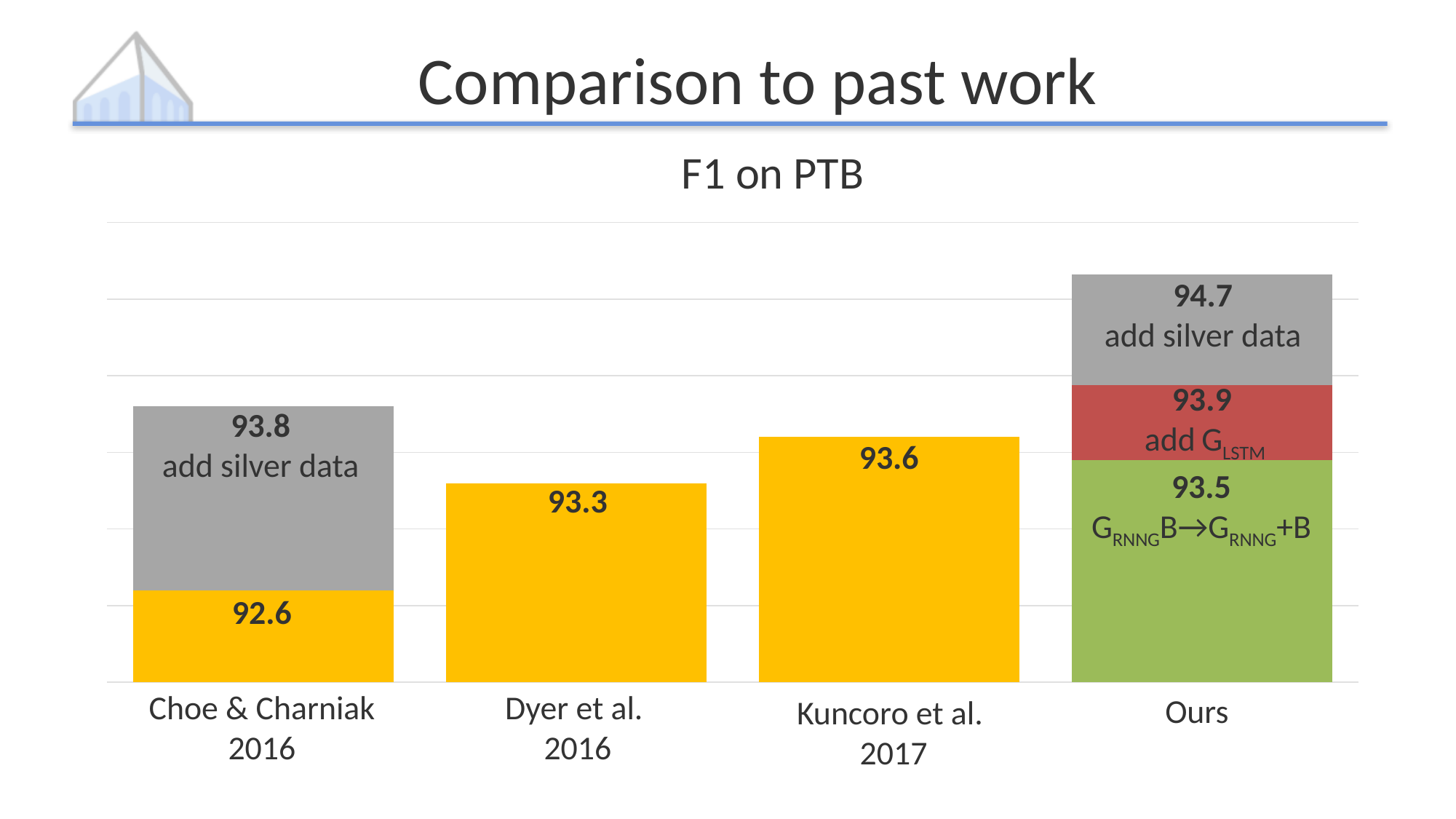
What is the base F1 value (yellow segment) labeled for Choe & Charniak 2016? 92.6 What F1 value is labeled for Choe & Charniak 2016 after adding silver data? 93.8 What is the highest F1 value labeled for the 'Ours' bar? 94.7 Which system has the tallest bar in the chart? Ours What F1 value is labeled on the bar for Kuncoro et al. 2017? 93.6 Which of Dyer et al. 2016 and Kuncoro et al. 2017 has the higher F1? Kuncoro et al. 2017 What type of chart is shown on the slide? bar chart What is the difference between the top F1 value of 'Ours' (94.7) and the top F1 value of Choe & Charniak 2016 (93.8)? 0.9 What F1 value is labeled on the red 'add G_LSTM' segment of the 'Ours' bar? 93.9 What is the title of the chart? F1 on PTB What F1 value is labeled on the bar for Dyer et al. 2016? 93.3 How many categories (systems) are shown on the x axis of the chart? 4